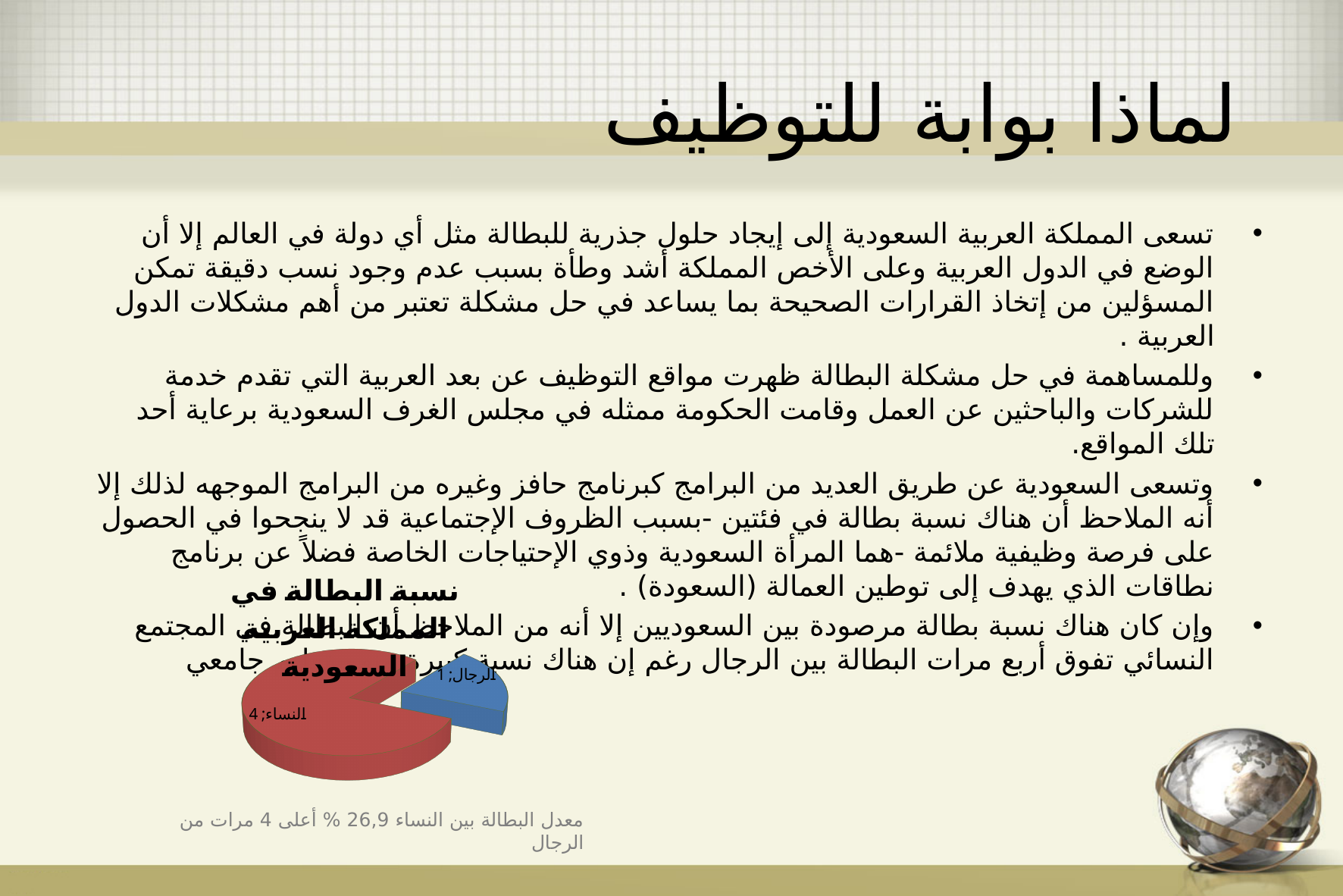
What share of the pie does the الرجال slice represent? 20% What is the value shown for الرجال (men) in the pie chart? 1 Which is larger in the pie chart, the value for النساء or the value for الرجال? النساء What share of the pie does the النساء slice represent? 80% Which slice of the pie chart is the largest? النساء Which slice of the pie chart is the smallest? الرجال What colour is the الرجال slice in the pie chart? Blue What type of chart is shown on the slide? Pie chart How many slices does the pie chart have? 2 What is the value shown for النساء (women) in the pie chart? 4 What is the difference between the values for النساء and الرجال in the pie chart? 3 What colour is the النساء slice in the pie chart? Red